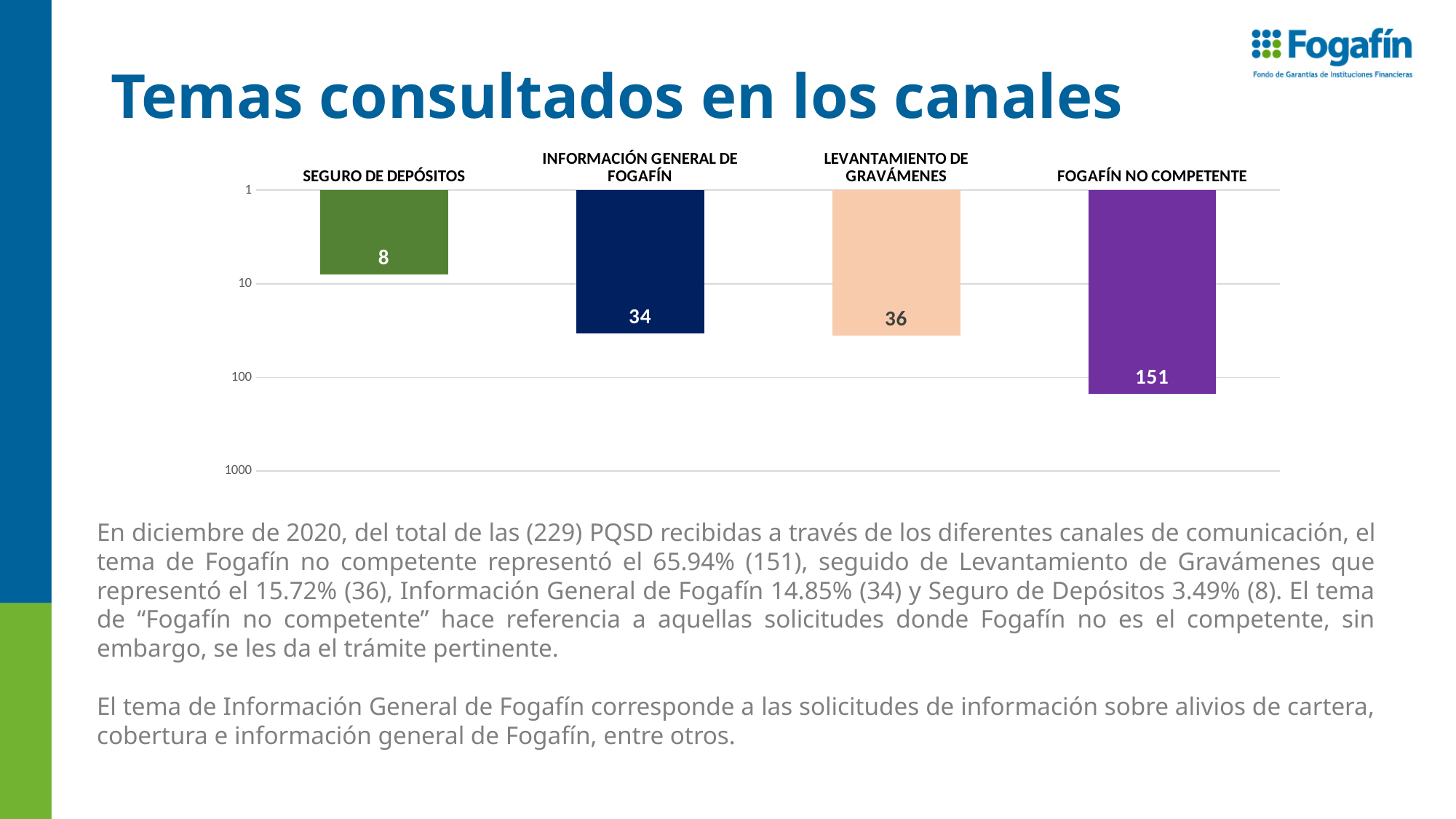
What is the value for SEGURO DE DEPÓSITOS? 8 How many categories are shown in the chart? 4 Which category has the highest value? FOGAFÍN NO COMPETENTE What is the value for LEVANTAMIENTO DE GRAVÁMENES? 36 Which is larger, the value for LEVANTAMIENTO DE GRAVÁMENES or the value for INFORMACIÓN GENERAL DE FOGAFÍN? LEVANTAMIENTO DE GRAVÁMENES What is the title of the slide containing the chart? Temas consultados en los canales Which category has the lowest value? SEGURO DE DEPÓSITOS What kind of chart is shown on the slide? Bar chart What is the value for FOGAFÍN NO COMPETENTE? 151 What is the value for INFORMACIÓN GENERAL DE FOGAFÍN? 34 What is the difference between the values for INFORMACIÓN GENERAL DE FOGAFÍN and SEGURO DE DEPÓSITOS? 26 What is the difference between the values for FOGAFÍN NO COMPETENTE and LEVANTAMIENTO DE GRAVÁMENES? 115